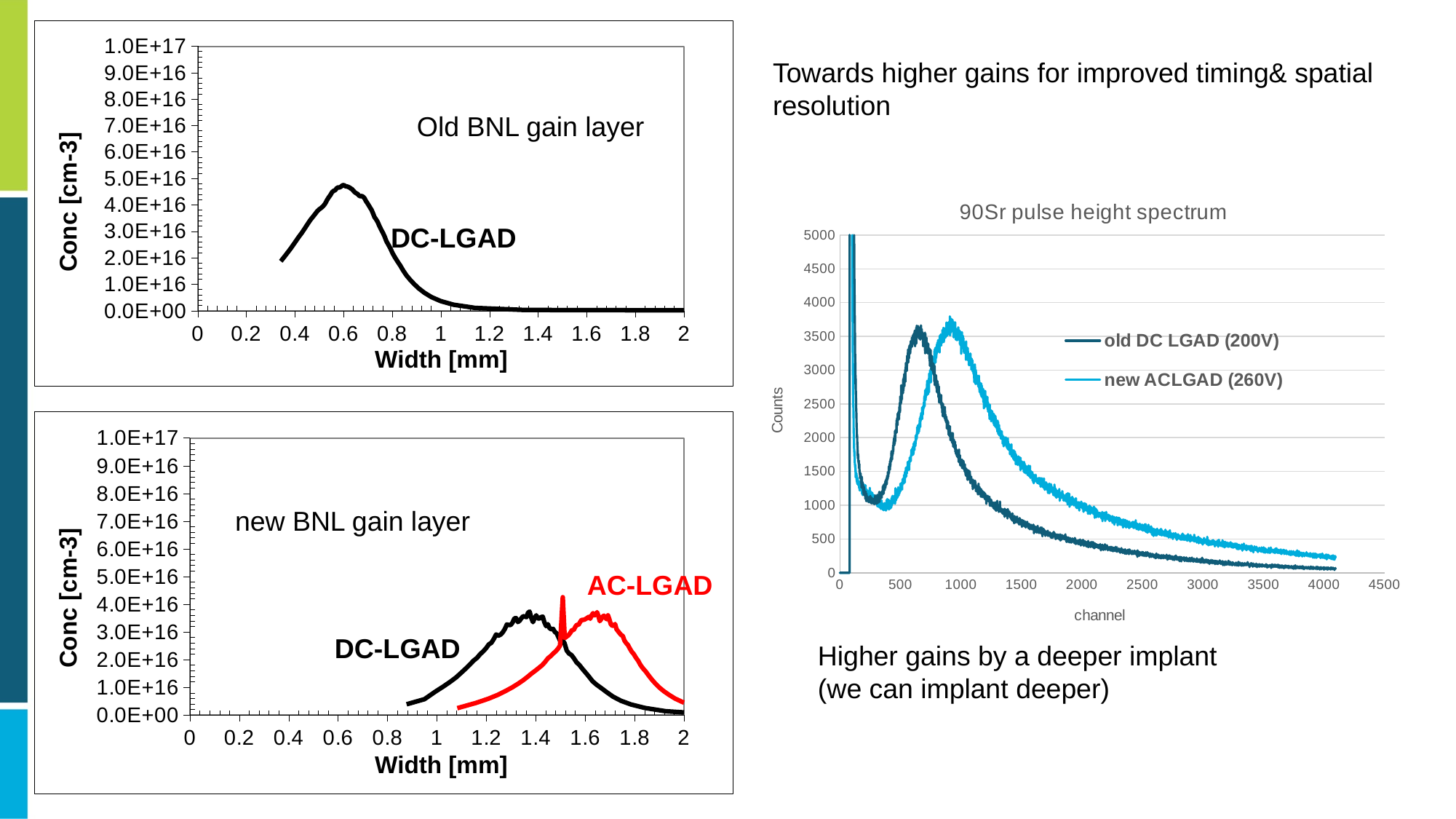
What is the label of the vertical axis of the '90Sr pulse height spectrum' chart? Counts In the 'new BNL gain layer' chart, is the peak concentration of the DC-LGAD curve greater or less than 3.0E+16? greater In the '90Sr pulse height spectrum' chart, at channel 2000, which series has the higher counts? new ACLGAD (260V) In the 'Old BNL gain layer' chart, is the peak of the DC-LGAD curve at a width greater or less than 1 mm? less In the '90Sr pulse height spectrum' chart, which series reaches its peak at a higher channel number, old DC LGAD (200V) or new ACLGAD (260V)? new ACLGAD (260V) What kind of chart is the '90Sr pulse height spectrum' chart? line chart In the 'new BNL gain layer' chart, which curve peaks at a larger width, DC-LGAD or AC-LGAD? AC-LGAD In the 'Old BNL gain layer' chart, is the peak concentration of the DC-LGAD curve greater or less than 4.0E+16? greater What is the highest tick value shown on the horizontal axis of the '90Sr pulse height spectrum' chart? 4500 How many series does the legend of the '90Sr pulse height spectrum' chart list? 2 What is the label of the horizontal axis of the 'new BNL gain layer' chart? Width [mm]